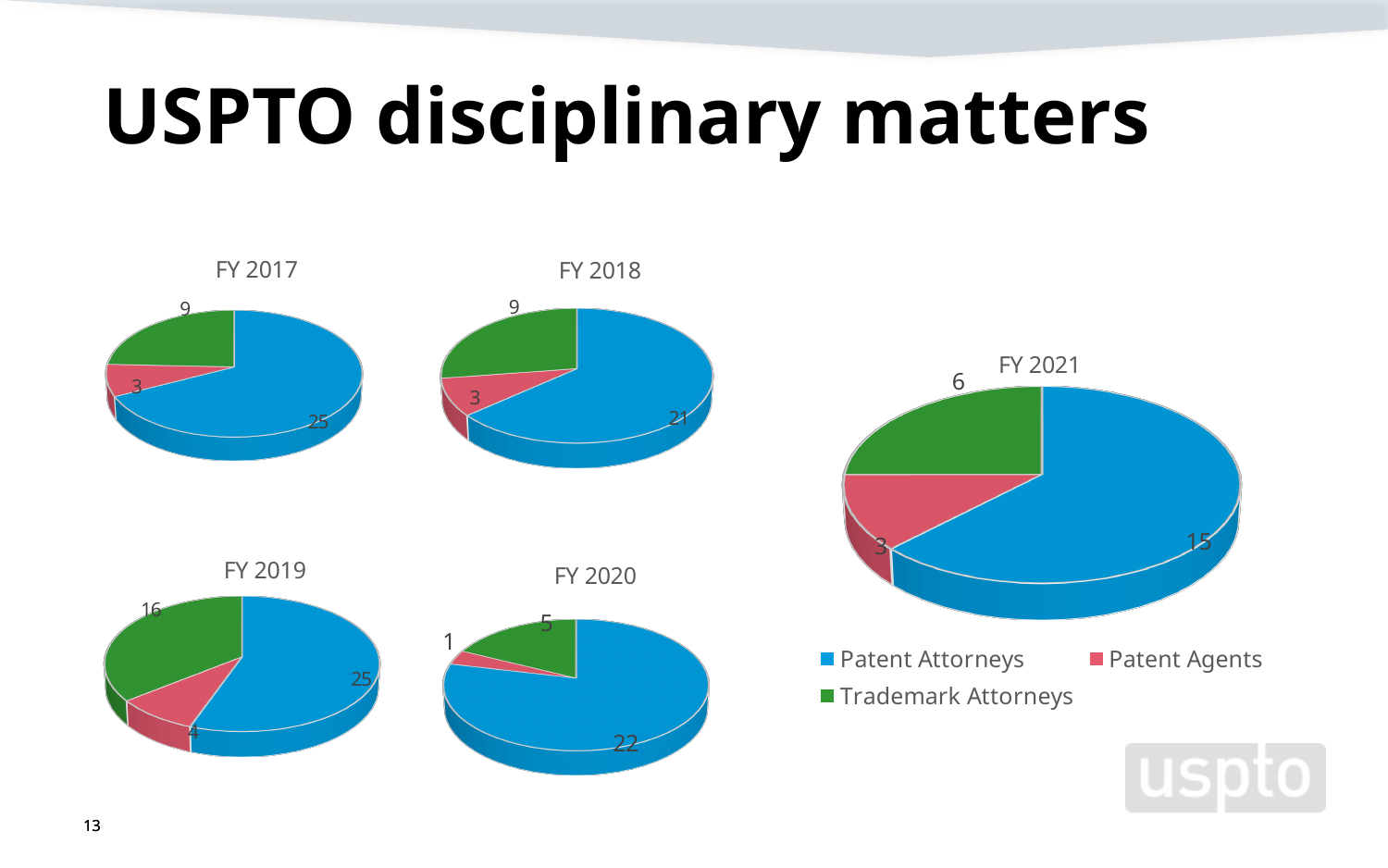
How many pie charts are shown on the slide? 5 What is the total of all slices in the FY 2020 chart? 28 Which is larger: the Trademark Attorneys value in FY 2019 or the Trademark Attorneys value in FY 2021? FY 2019 In the FY 2018 chart, which category has the smallest slice? Patent Agents In the FY 2019 chart, what is the difference between the Patent Attorneys value and the Trademark Attorneys value? 9 In the FY 2020 chart, what is the value for Patent Agents? 1 What share of the FY 2021 pie does the Patent Agents slice represent? 12.5% What type of chart is used for FY 2018? Pie chart How many series does the legend list? 3 In the FY 2021 chart, which category has the largest slice? Patent Attorneys In the FY 2019 chart, what is the value for Trademark Attorneys? 16 In the FY 2017 chart, what is the value for Patent Attorneys? 25